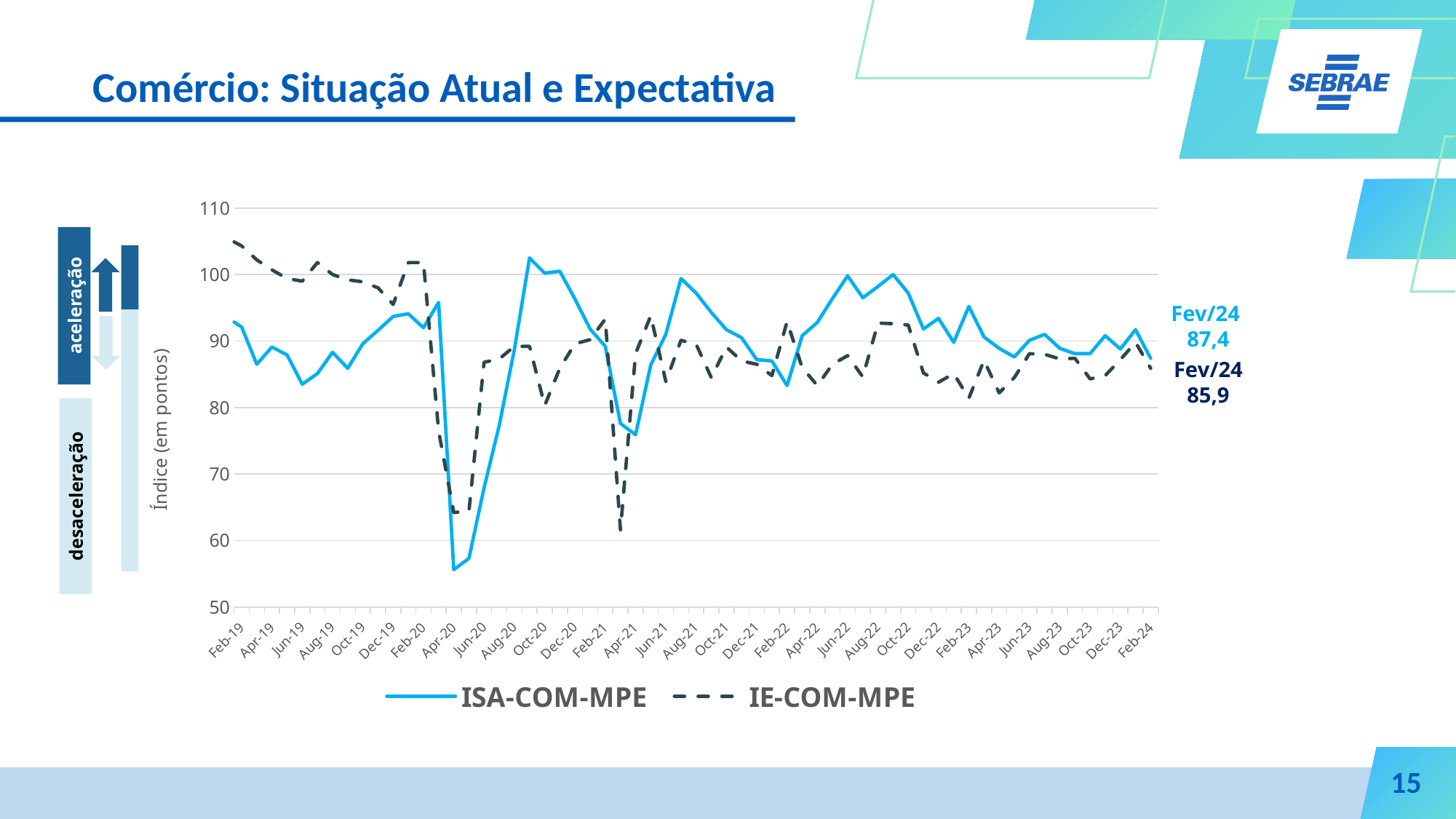
Which series reaches the lowest point on the chart? ISA-COM-MPE What is the value of ISA-COM-MPE in Fev/24? 87,4 What kind of chart is shown on the slide? line chart Is the value for IE-COM-MPE in Feb-19 greater or less than 100? greater How many series does the legend list? 2 What is the title of the vertical axis? Índice (em pontos) What is the value of IE-COM-MPE in Fev/24? 85,9 Is the value for ISA-COM-MPE in Apr-20 greater or less than 60? less Is the value for ISA-COM-MPE in Feb-19 greater or less than 90? greater Which series has the higher value in Fev/24, ISA-COM-MPE or IE-COM-MPE? ISA-COM-MPE What is the difference between the ISA-COM-MPE and IE-COM-MPE values in Fev/24? 1,5